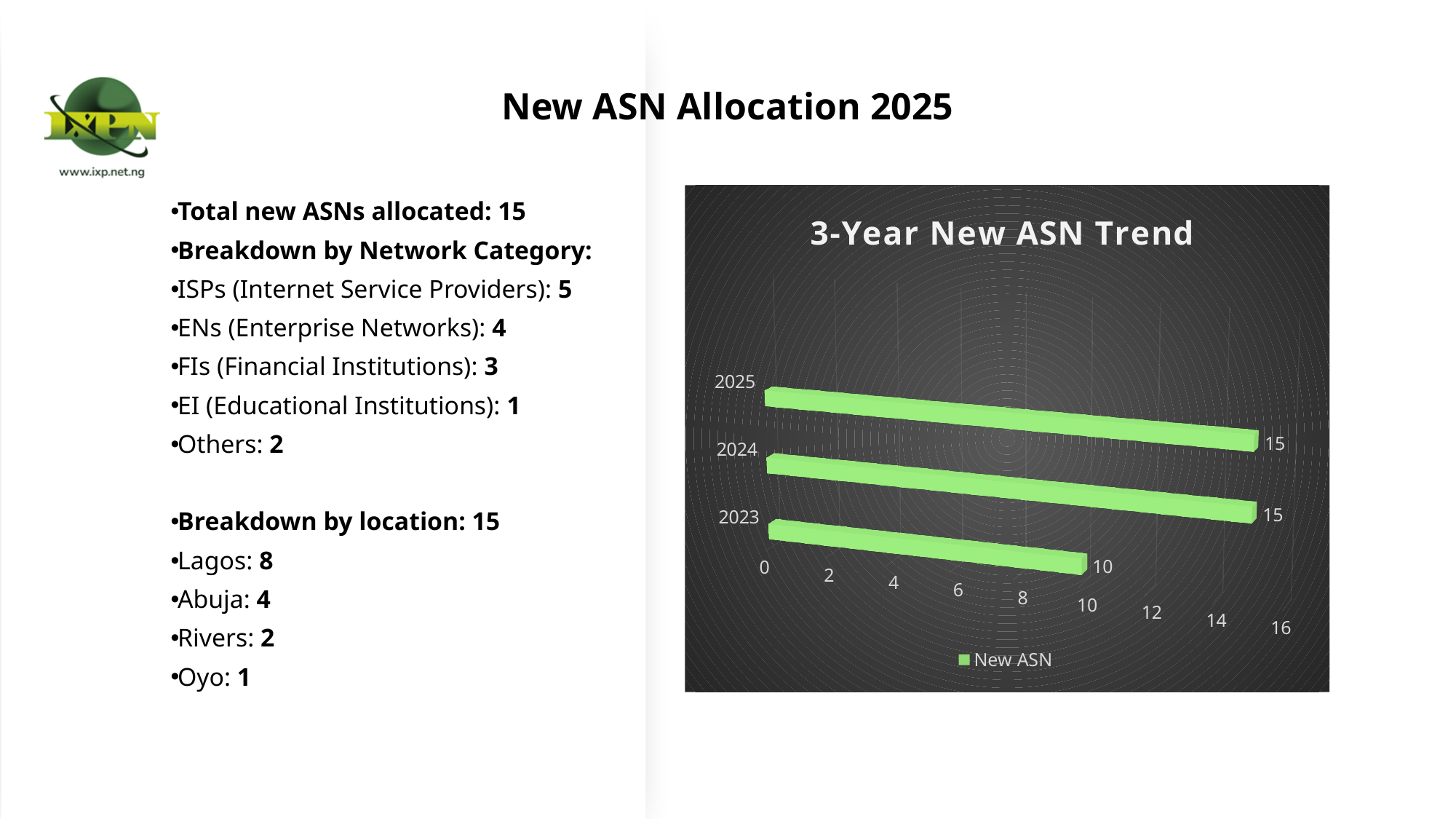
Which is larger in the chart, the value for 2024 or the value for 2023? 2024 Which year has the lowest value in the 3-Year New ASN Trend chart? 2023 What is the value for 2023 in the 3-Year New ASN Trend chart? 10 How many years are shown in the 3-Year New ASN Trend chart? 3 How many series does the chart legend list? 1 What is the title of the chart on the slide? 3-Year New ASN Trend What kind of chart is the 3-Year New ASN Trend chart? bar chart What is the name of the series in the chart legend? New ASN What is the difference between the values for 2025 and 2023 in the chart? 5 What is the value for 2025 in the 3-Year New ASN Trend chart? 15 What is the value for 2024 in the 3-Year New ASN Trend chart? 15 Is the value for 2023 in the chart greater or less than 12? less